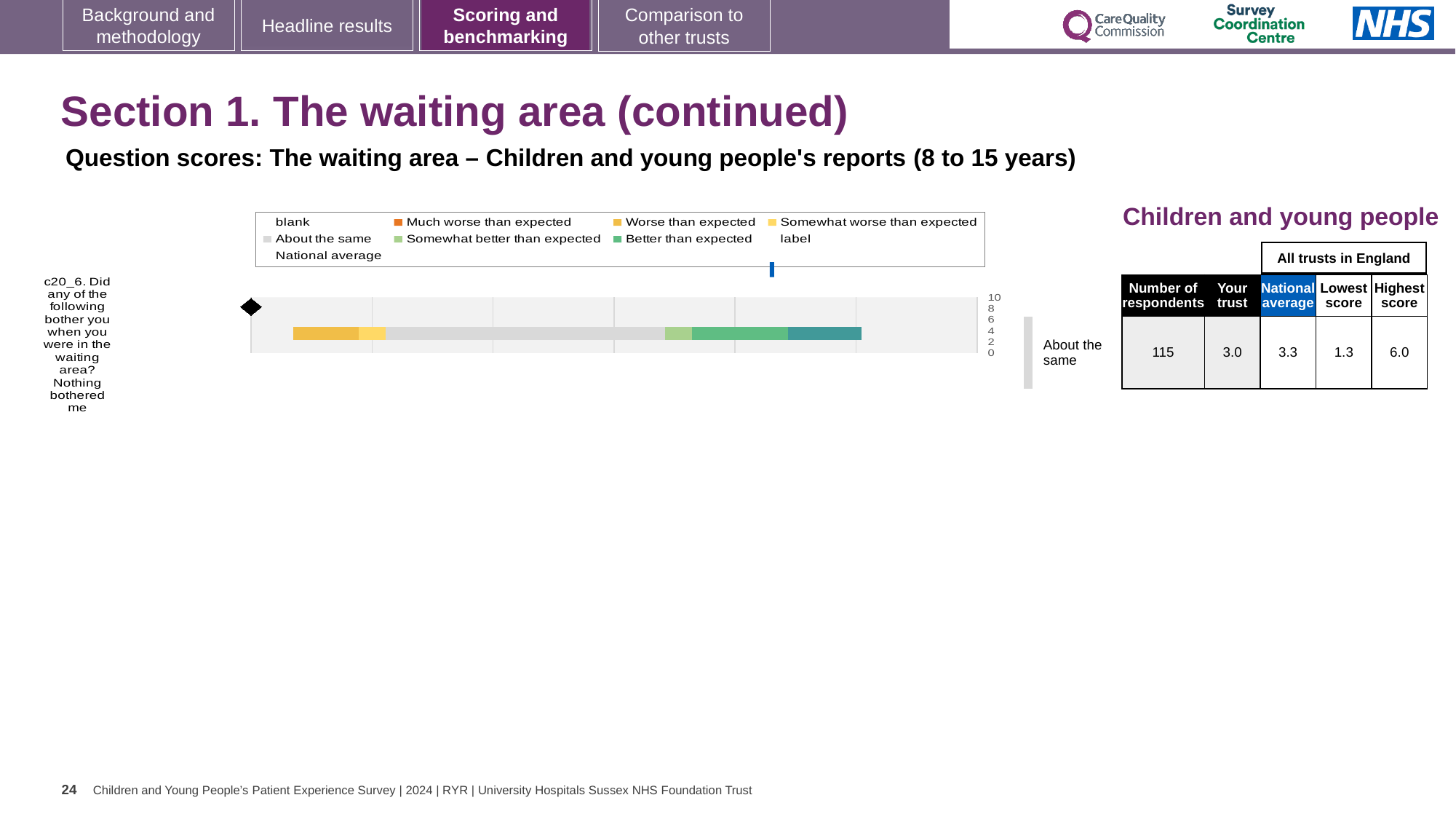
What kind of chart is shown on the slide? bar chart What is the question code of the single category plotted in the chart? c20_6 Which benchmark band is the trust's score for c20_6 labelled as falling in, according to the label to the right of the chart? About the same In the table beside the chart, what is the difference between the highest score and the lowest score for c20_6? 4.7 How many entries does the chart legend list? 9 In the table beside the chart, what is the 'Your trust' score for c20_6? 3.0 In the table beside the chart, what is the lowest score among all trusts in England for c20_6? 1.3 How many question categories are plotted in the bar chart? 1 In the table beside the chart, what is the highest score among all trusts in England for c20_6? 6.0 In the table beside the chart, what is the national average score for c20_6? 3.3 In the table beside the chart, what is the number of respondents for c20_6? 115 In the table beside the chart, which is larger for c20_6: the 'Your trust' score or the national average? National average